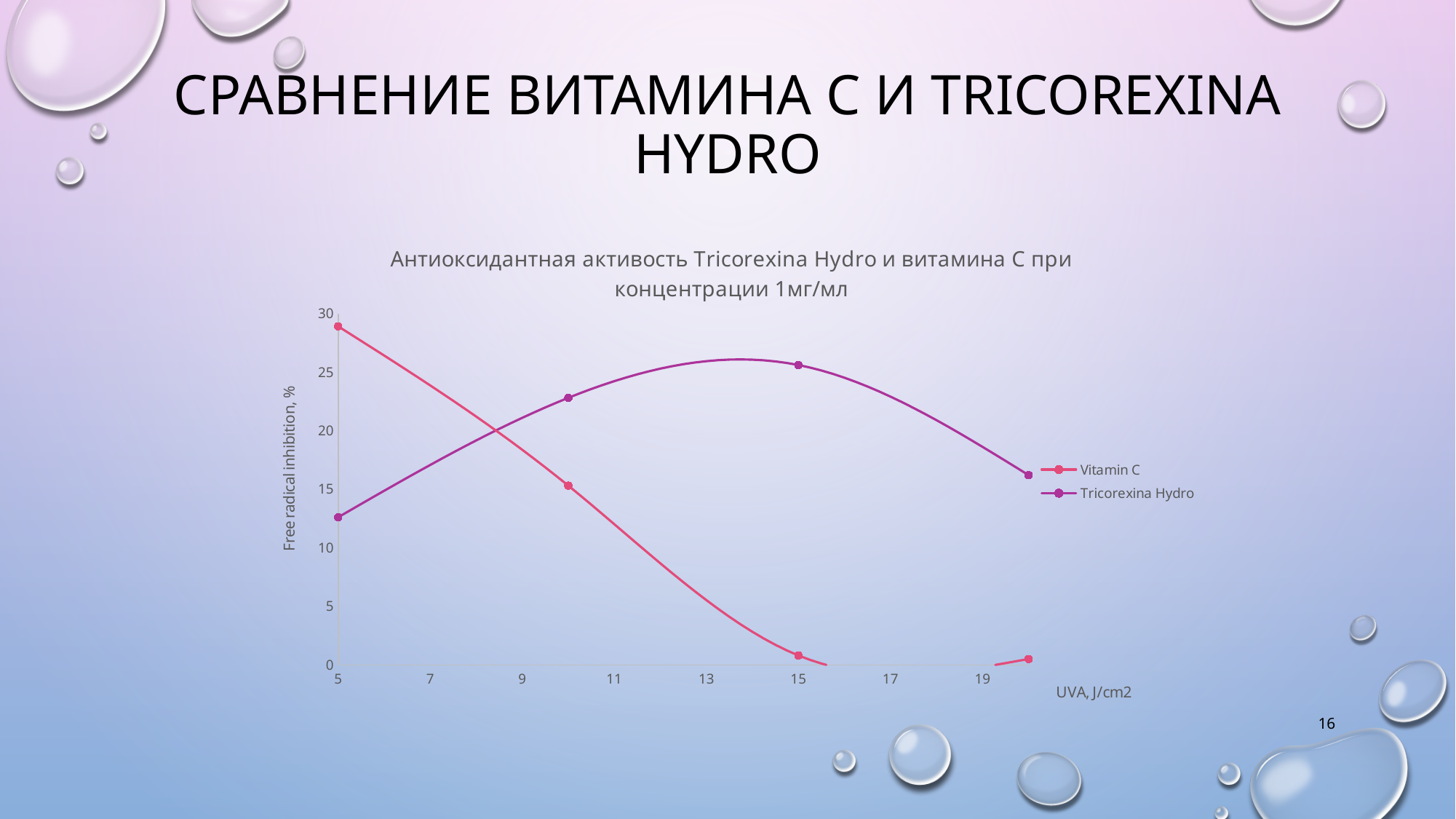
Is the value for Tricorexina Hydro at UVA 5 J/cm2 greater or less than 15? less At UVA 5 J/cm2, which series has the higher free radical inhibition, Vitamin C or Tricorexina Hydro? Vitamin C At which UVA value does the Tricorexina Hydro series reach its highest point? 15 Is the value for Vitamin C at UVA 15 J/cm2 greater or less than 5? less Is the value for Vitamin C at UVA 5 J/cm2 greater or less than 25? greater What kind of chart is shown on the slide? Line chart How many series does the legend list? 2 What are the two series named in the legend? Vitamin C and Tricorexina Hydro How many data points are plotted for the Vitamin C series? 4 What is the label of the vertical axis? Free radical inhibition, % Does the Vitamin C line rise or fall as UVA increases along the x axis? Fall